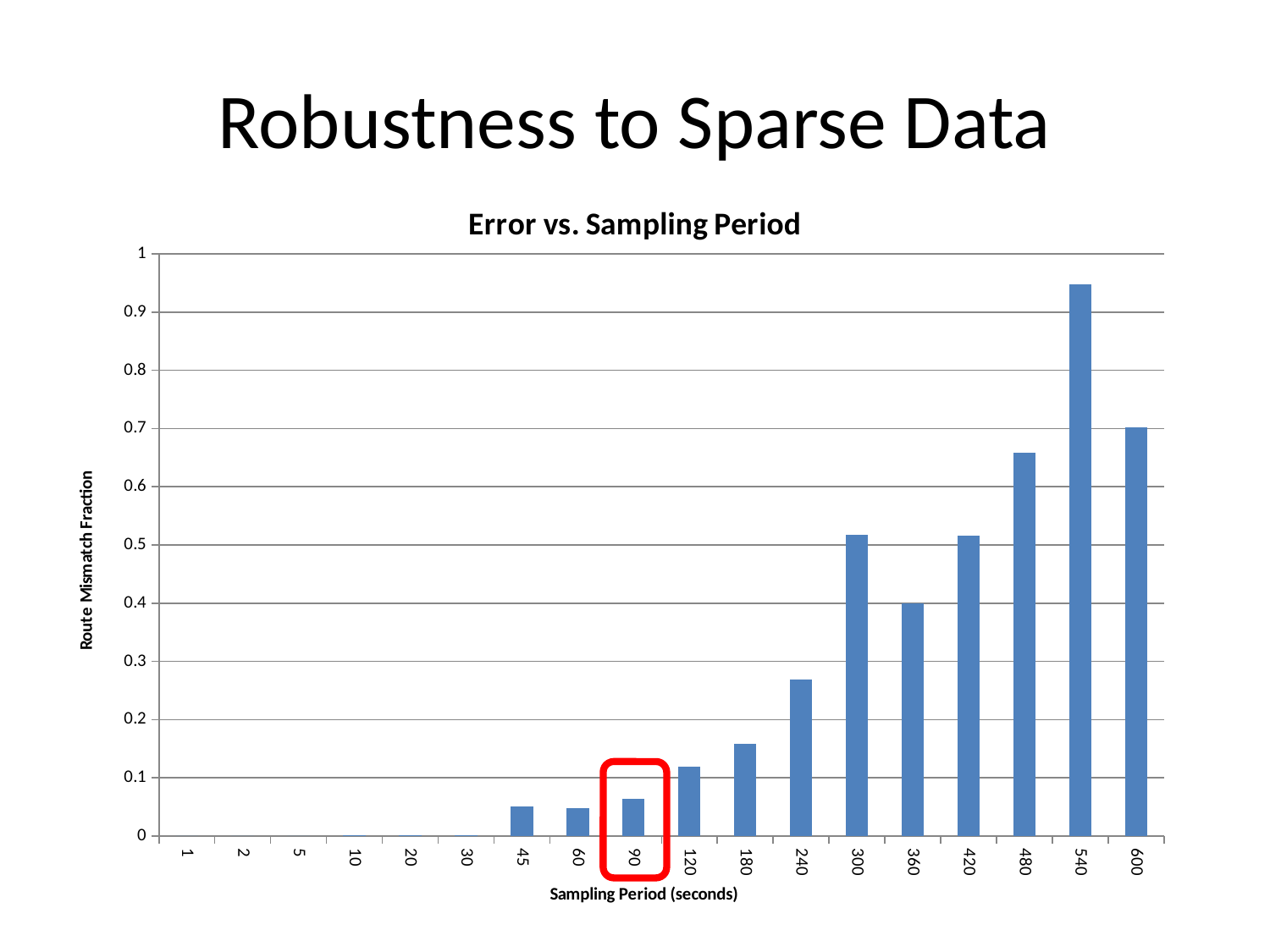
Which has the larger route mismatch fraction, sampling period 540 or 600? 540 Do the route mismatch fraction values generally rise or fall as the sampling period increases along the x axis? rise What kind of chart is shown on the slide? bar chart Is the value for sampling period 480 greater or less than 0.6? greater Is the value for sampling period 240 greater or less than 0.3? less What is the title of the chart? Error vs. Sampling Period Which sampling period has the highest route mismatch fraction? 540 Is the value for sampling period 360 greater or less than 0.5? less How many sampling period categories are shown on the x axis? 18 Which has the larger route mismatch fraction, sampling period 480 or 360? 480 What is the label of the vertical axis? Route Mismatch Fraction